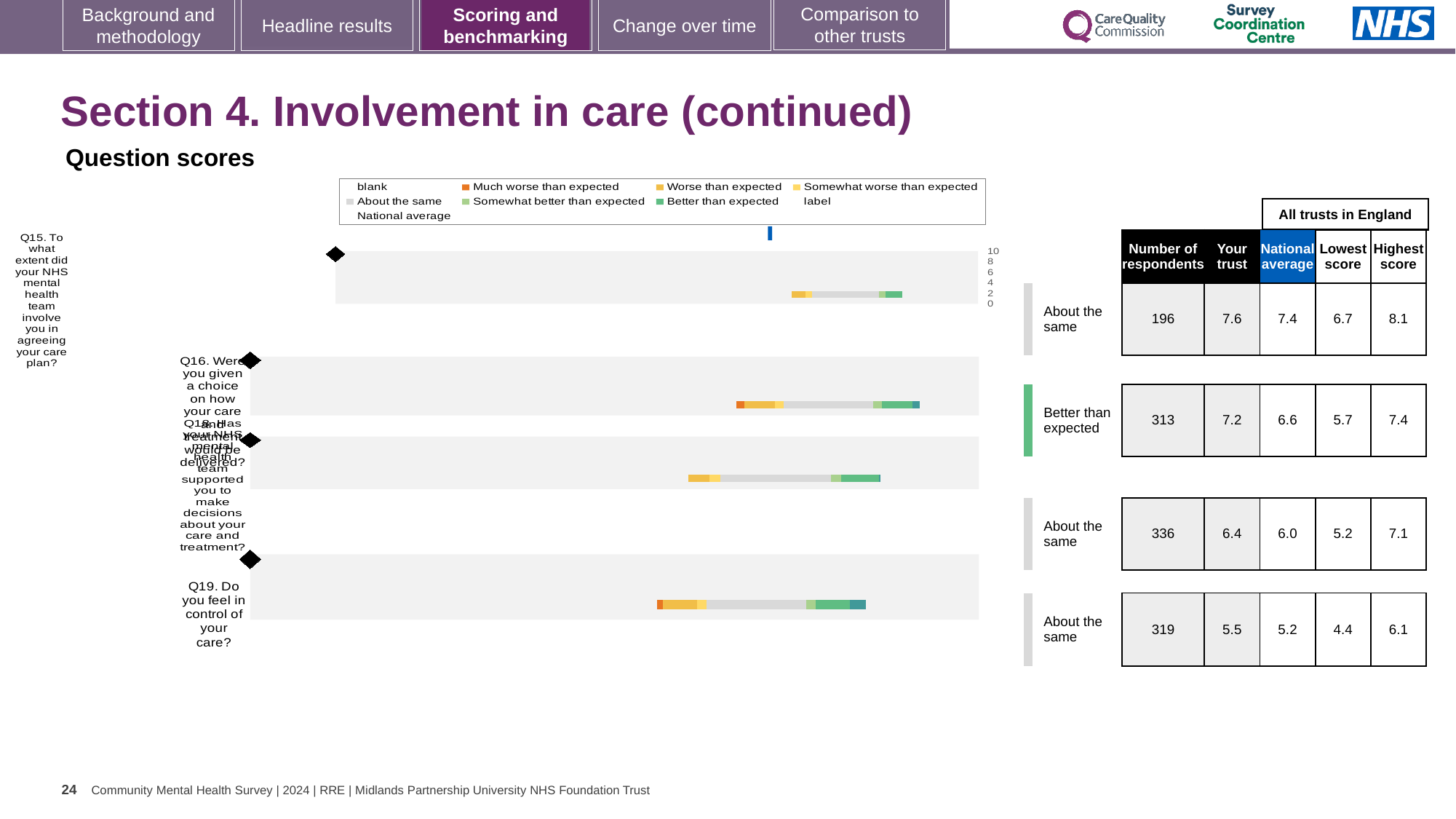
What is the highest score among all trusts in England for Q19? 6.1 Which question has the highest 'Your trust' score? Q15 For Q15, how much higher is the 'Your trust' score than the national average? 0.2 What is the national average for the question rated 'Better than expected'? 6.6 How many questions are plotted in the question scores chart? 4 How many respondents answered Q19 (Do you feel in control of your care?)? 319 What kind of chart is used to show the question scores on this slide? bar chart For Q19, which is larger: the 'Your trust' score or the national average? Your trust Which question is rated 'Better than expected' rather than 'About the same'? Q16 Which question has the lowest 'Your trust' score? Q19 What is the lowest score among all trusts in England for Q15? 6.7 What is the 'Your trust' score for Q15 (involvement in agreeing your care plan)? 7.6